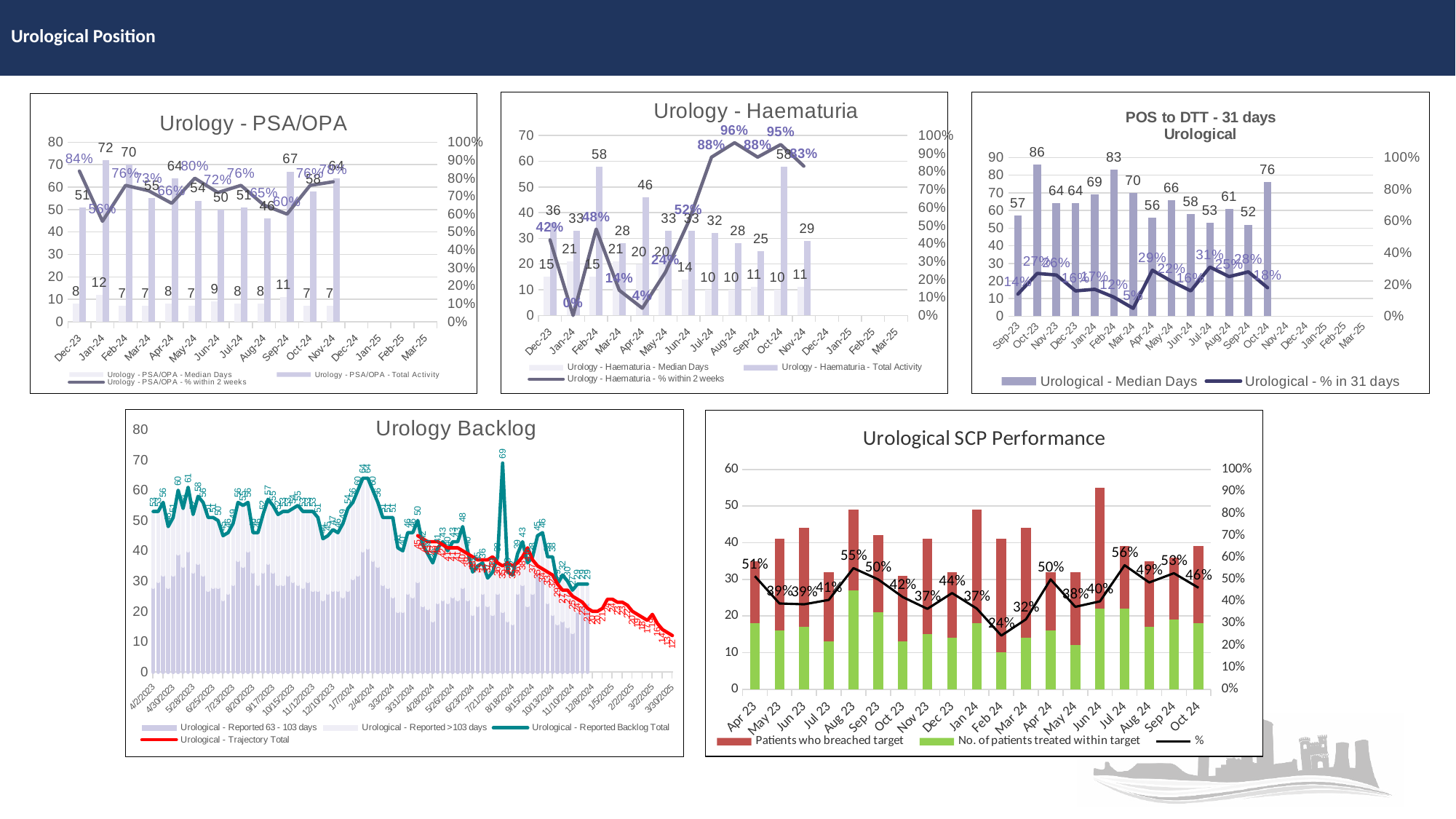
How many series does the legend of the Urology Backlog chart list? 4 In the Urological SCP Performance chart, which month has the highest % value? Jul 24 In the Urology - PSA/OPA chart, which month has the lowest Total Activity? Aug-24 In the Urology - Haematuria chart, which month has the lowest % within 2 weeks? Jan-24 In the Urology - Haematuria chart, what is the difference in Total Activity between Feb-24 and Mar-24? 30 In the Urology - PSA/OPA chart, what is the Total Activity value for Jan-24? 72 In the POS to DTT - 31 days Urological chart, what is the % in 31 days for Mar-24? 5% In the POS to DTT - 31 days Urological chart, is the Median Days value for Feb-24 larger than for Jan-24? Yes In the POS to DTT - 31 days Urological chart, which month has the highest Median Days? Oct-23 In the Urological SCP Performance chart, what is the % value for Feb 24? 24% In the Urology - Haematuria chart, what is the % within 2 weeks for Aug-24? 96% In the Urology - PSA/OPA chart, what is the % within 2 weeks for Dec-23? 84%